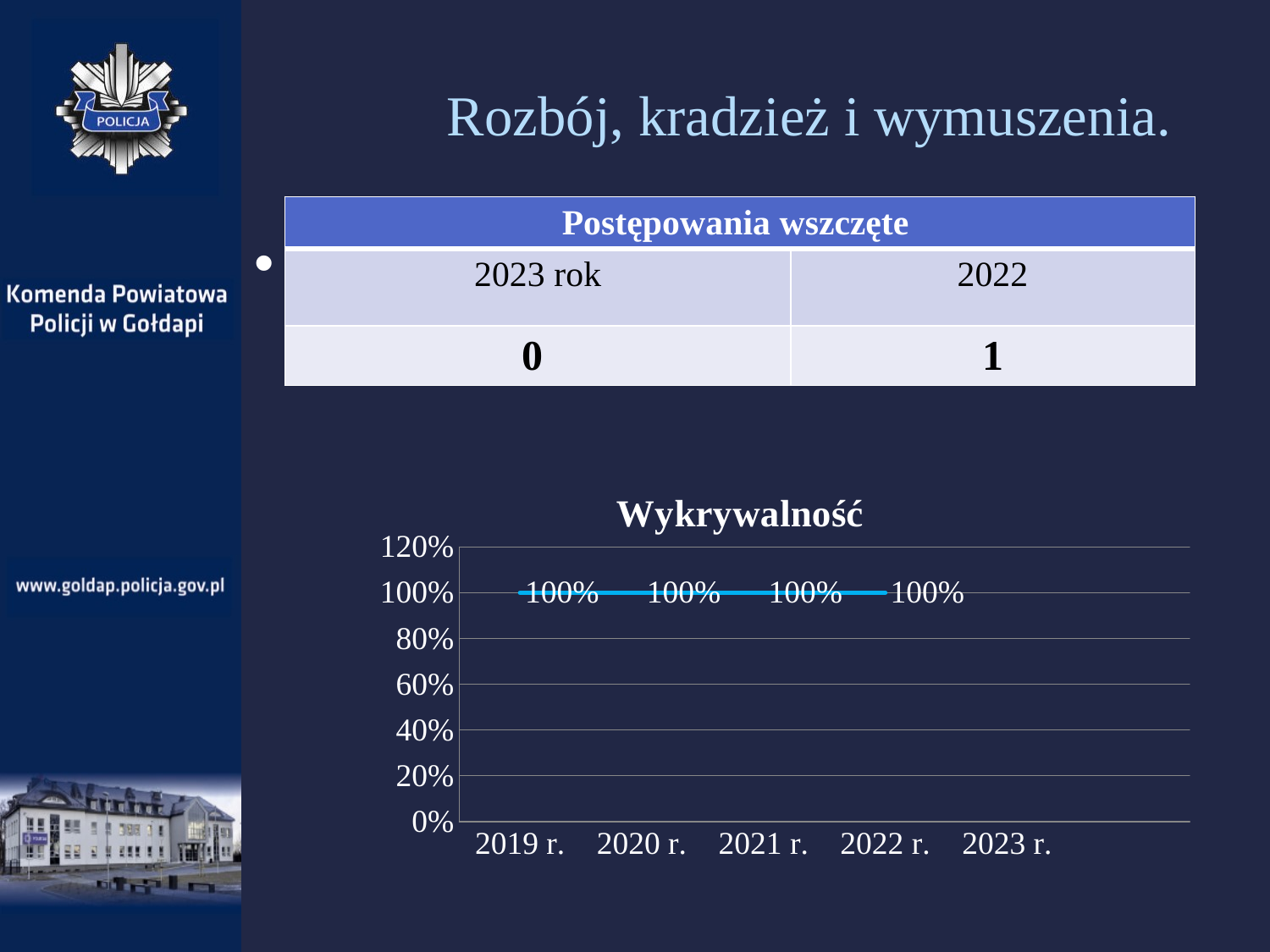
In the 'Wykrywalność' chart, what is the value for 2022 r.? 100% In the 'Wykrywalność' chart, what is the value for 2020 r.? 100% How many year labels are shown on the x axis of the 'Wykrywalność' chart? 5 How many data labels are printed on the line in the 'Wykrywalność' chart? 4 What is the highest tick value shown on the y axis of the 'Wykrywalność' chart? 120% What kind of chart is the 'Wykrywalność' chart? line chart In the 'Wykrywalność' chart, is the value for 2020 r. greater or less than 80%? greater In the 'Wykrywalność' chart, what is the value for 2021 r.? 100% Do the values in the 'Wykrywalność' chart rise, fall or stay flat from 2019 r. to 2022 r.? stay flat In the 'Wykrywalność' chart, what is the difference between the values for 2019 r. and 2022 r.? 0% In the 'Wykrywalność' chart, what is the value for 2019 r.? 100% What is the title of the chart on the slide? Wykrywalność